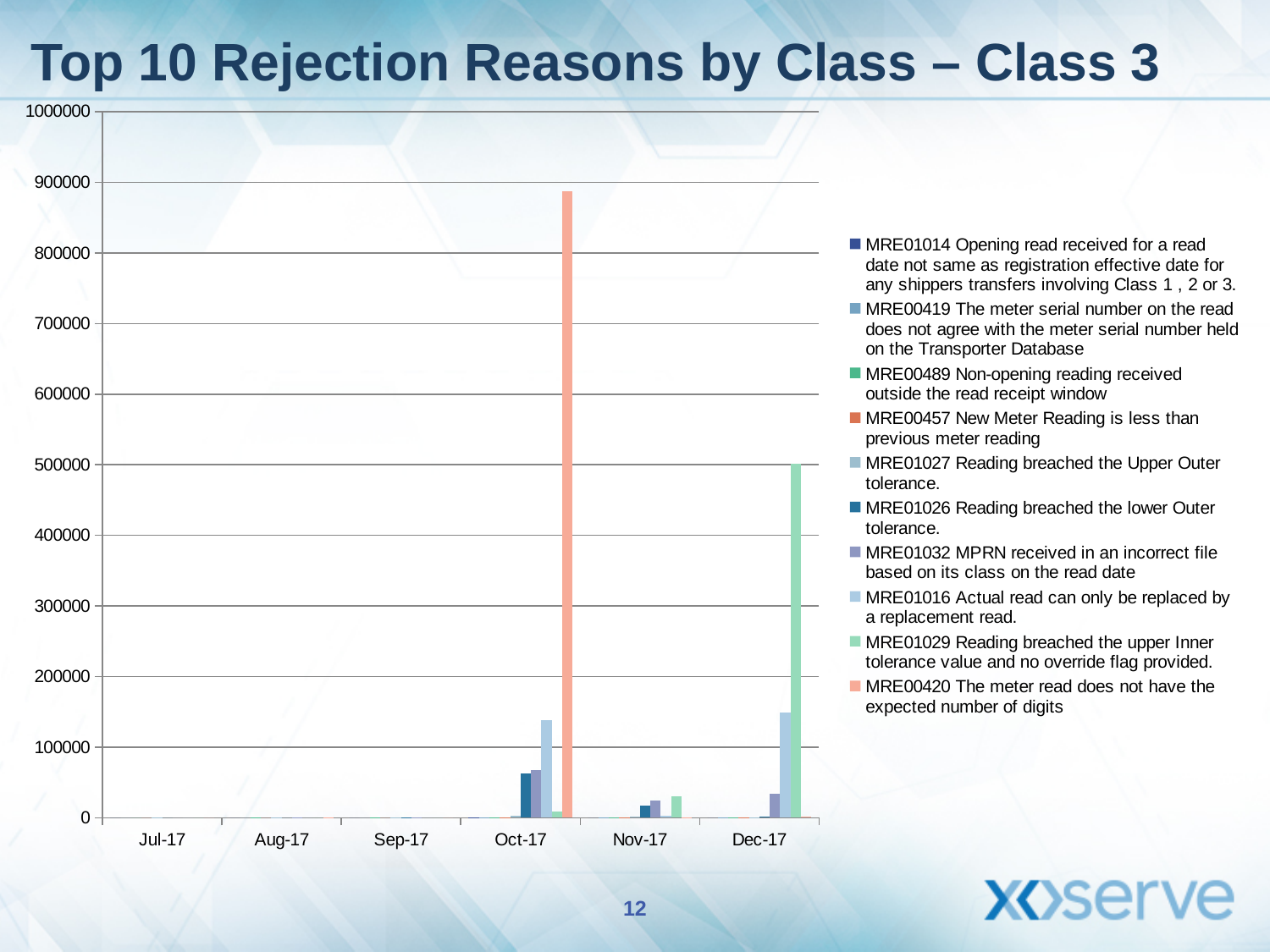
How many months are shown on the x axis of the chart? 6 What is the title of the slide containing the chart? Top 10 Rejection Reasons by Class – Class 3 How many series does the chart's legend list? 10 What kind of chart is shown on the slide? Bar chart Is the value for MRE01016 in Oct-17 greater or less than 200000? less Is the value for MRE01029 in Dec-17 greater or less than 400000? greater Is the value for MRE00420 in Oct-17 greater or less than 800000? greater Which rejection reason has the tallest bar in Dec-17? MRE01029 Reading breached the upper Inner tolerance value and no override flag provided. Which is larger: the MRE00420 bar in Oct-17 or the MRE01029 bar in Dec-17? MRE00420 in Oct-17 Which rejection reason has the tallest bar in Oct-17? MRE00420 The meter read does not have the expected number of digits Which month has the tallest bar in the chart? Oct-17